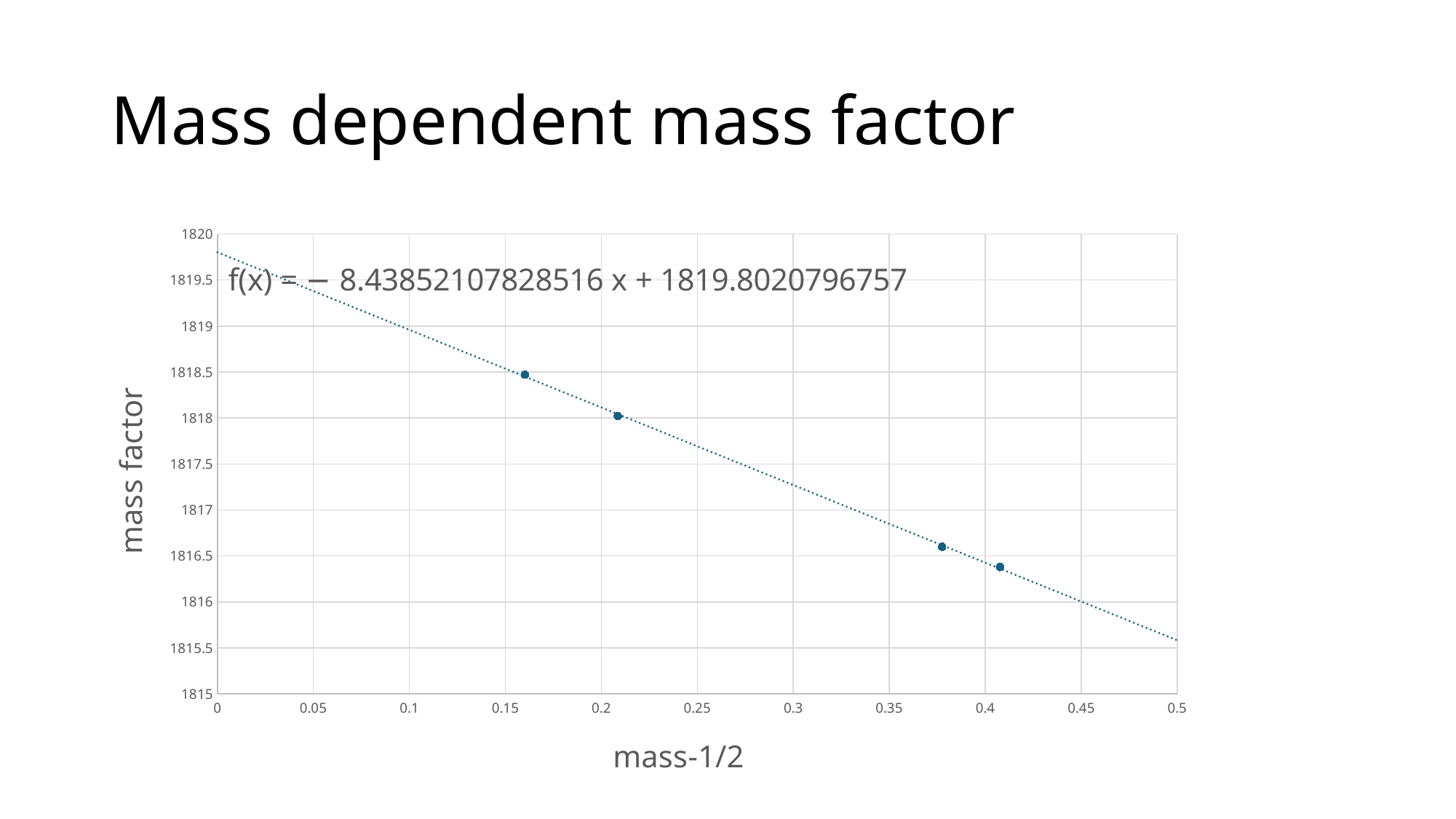
Is the mass factor value for the leftmost data point greater or less than 1819? less Which data point has the higher mass factor, the leftmost or the rightmost? The leftmost Is the mass factor value for the rightmost data point greater or less than 1816? greater Do the plotted mass factor values rise or fall as mass-1/2 increases along the x axis? Fall Is the mass factor value for the leftmost data point greater or less than 1818? greater What is the intercept shown in the trendline equation on the chart? 1819.8020796757 What is the title of the chart's y axis? mass factor How many data points are plotted on the chart? 4 What kind of chart is shown on the slide? Scatter chart